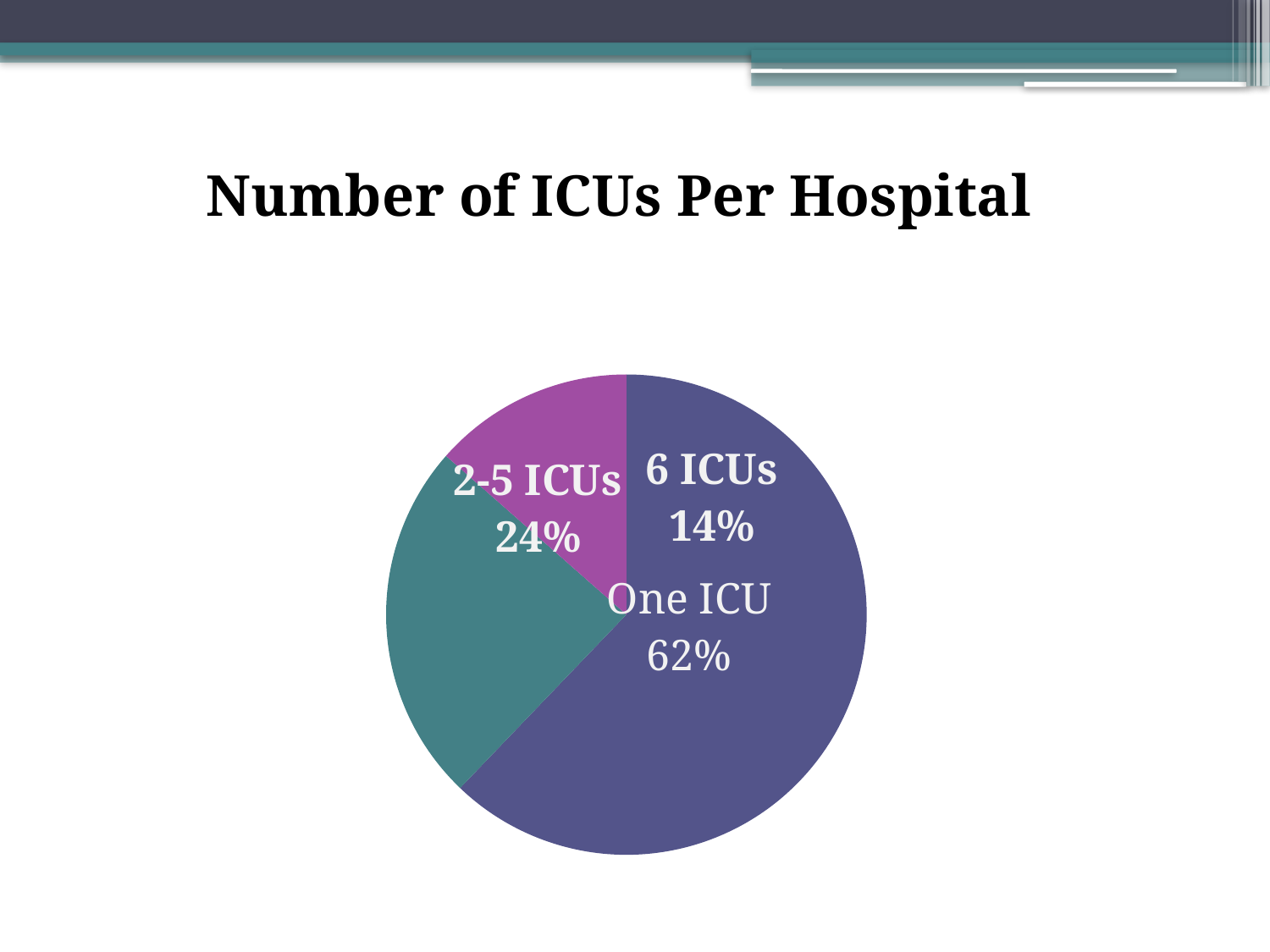
What kind of chart is shown on the slide? pie chart Which is larger, the share for 2-5 ICUs or the share for 6 ICUs? 2-5 ICUs What is the difference in percentage points between One ICU and 2-5 ICUs? 38 What percentage of hospitals have 6 ICUs? 14% What is the title of the chart? Number of ICUs Per Hospital What is the difference in percentage points between 2-5 ICUs and 6 ICUs? 10 What is the combined share of hospitals with 2-5 ICUs and 6 ICUs? 38% Which category has the largest share of the pie? One ICU What percentage of hospitals have 2-5 ICUs? 24% How many slices does the pie chart have? 3 What percentage of hospitals have one ICU? 62% Which category has the smallest share of the pie? 6 ICUs